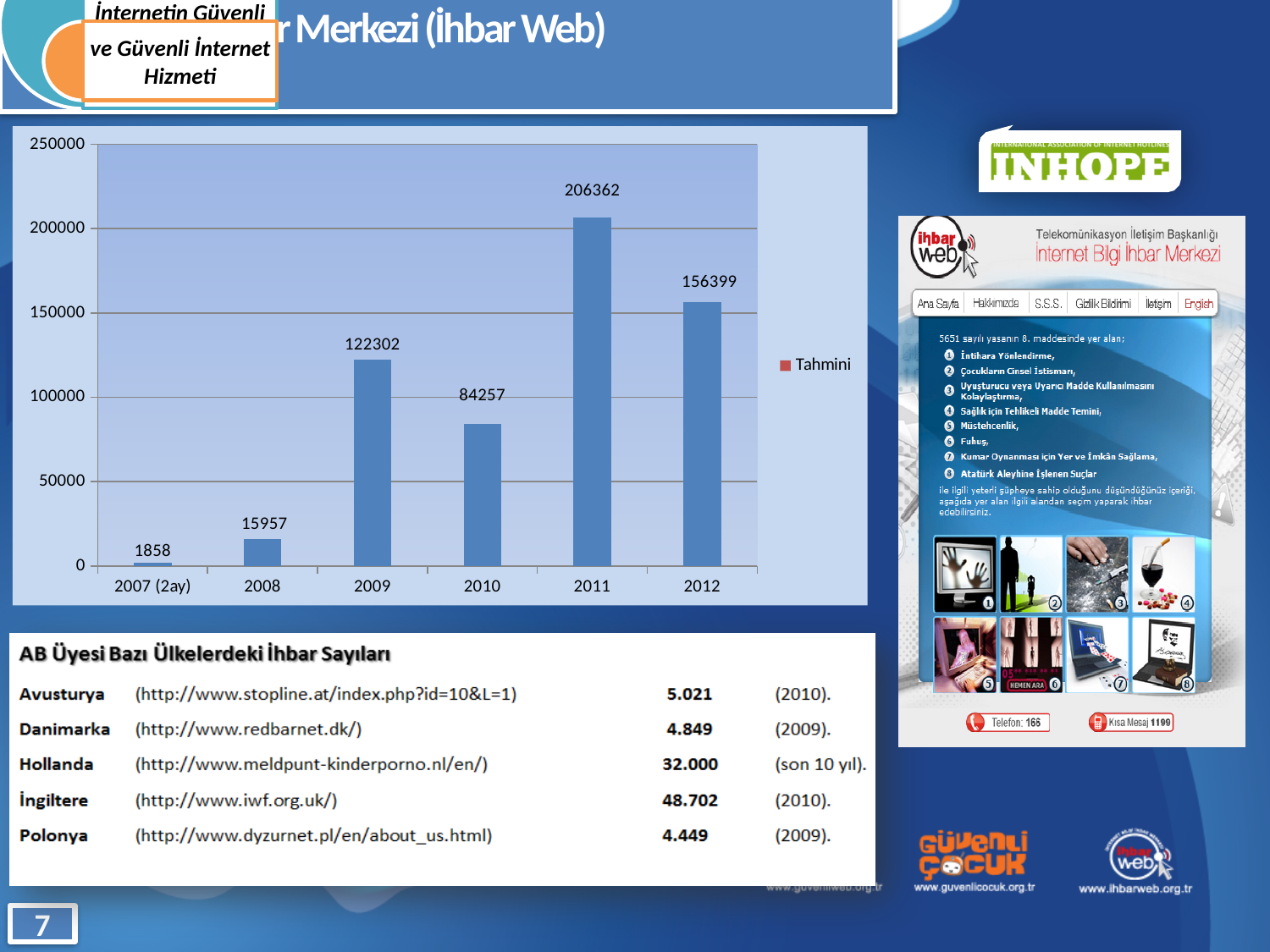
What is the value for 2010? 84257 What is the difference between the values for 2011 and 2012? 49963 What is the name of the series listed in the legend? Tahmini Which is larger, the value for 2009 or the value for 2010? 2009 What is the value for 2007 (2ay)? 1858 What is the difference between the values for 2009 and 2008? 106345 What kind of chart is shown on the slide? bar chart Is the value for 2012 greater or less than 150000? greater Which year has the highest value? 2011 Which category has the lowest value? 2007 (2ay) What is the value for 2011? 206362 How many categories are shown on the x axis? 6